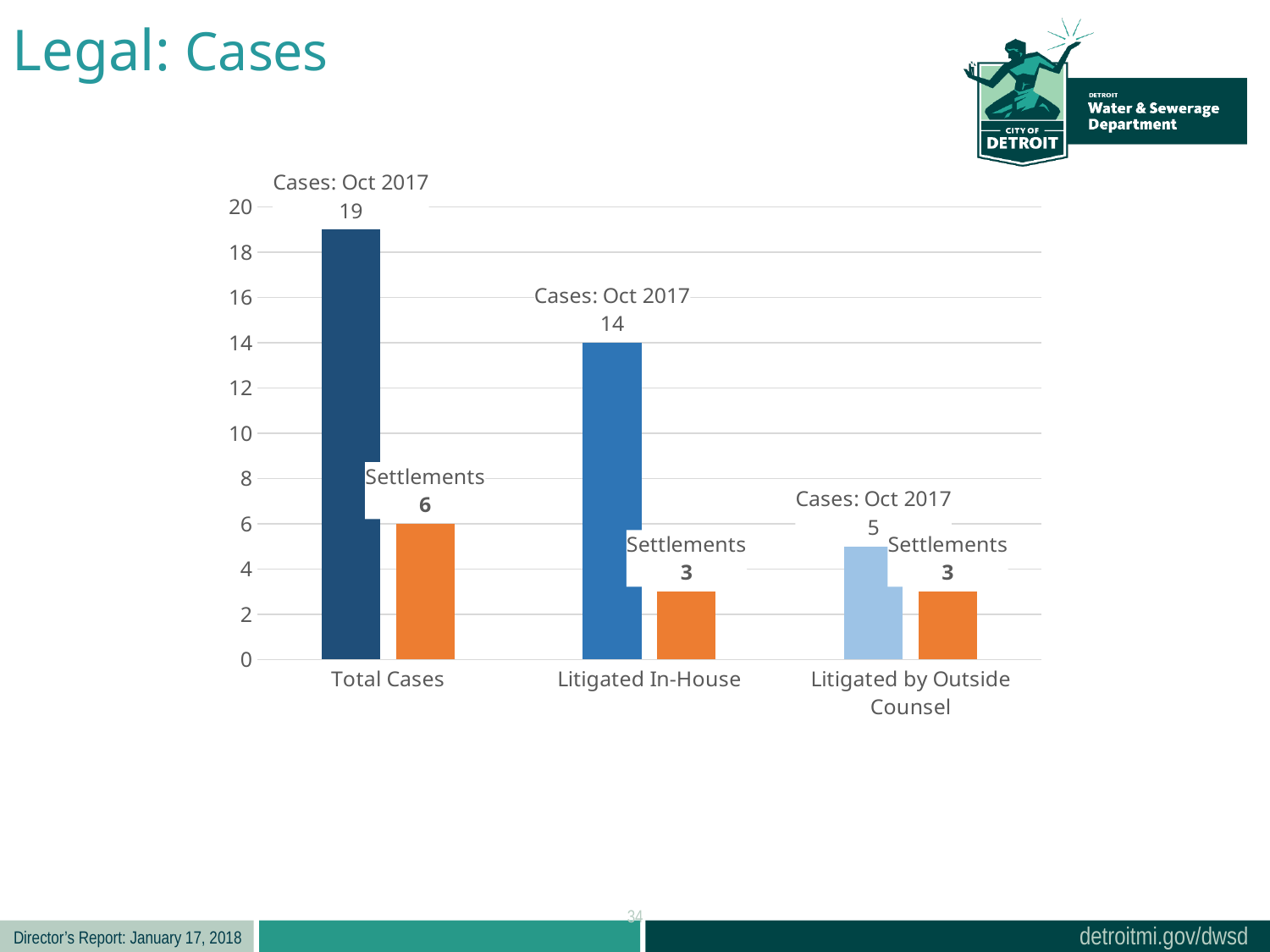
Is the Cases: Oct 2017 value for Litigated In-House greater or less than 10? greater What is the Cases: Oct 2017 value for Litigated by Outside Counsel? 5 What is the difference between Cases: Oct 2017 and Settlements for Total Cases? 13 Which category has the highest Cases: Oct 2017 value? Total Cases What kind of chart is shown on the slide? Bar chart Which is larger: Settlements for Total Cases or Cases: Oct 2017 for Litigated by Outside Counsel? Settlements for Total Cases How many Settlements are shown for Litigated In-House? 3 Which category has the lowest Cases: Oct 2017 value? Litigated by Outside Counsel How many categories are shown on the x axis? 3 How many Settlements are shown for Total Cases? 6 What is the difference between Cases: Oct 2017 for Litigated In-House and Litigated by Outside Counsel? 9 What is the number of Cases: Oct 2017 for Total Cases? 19